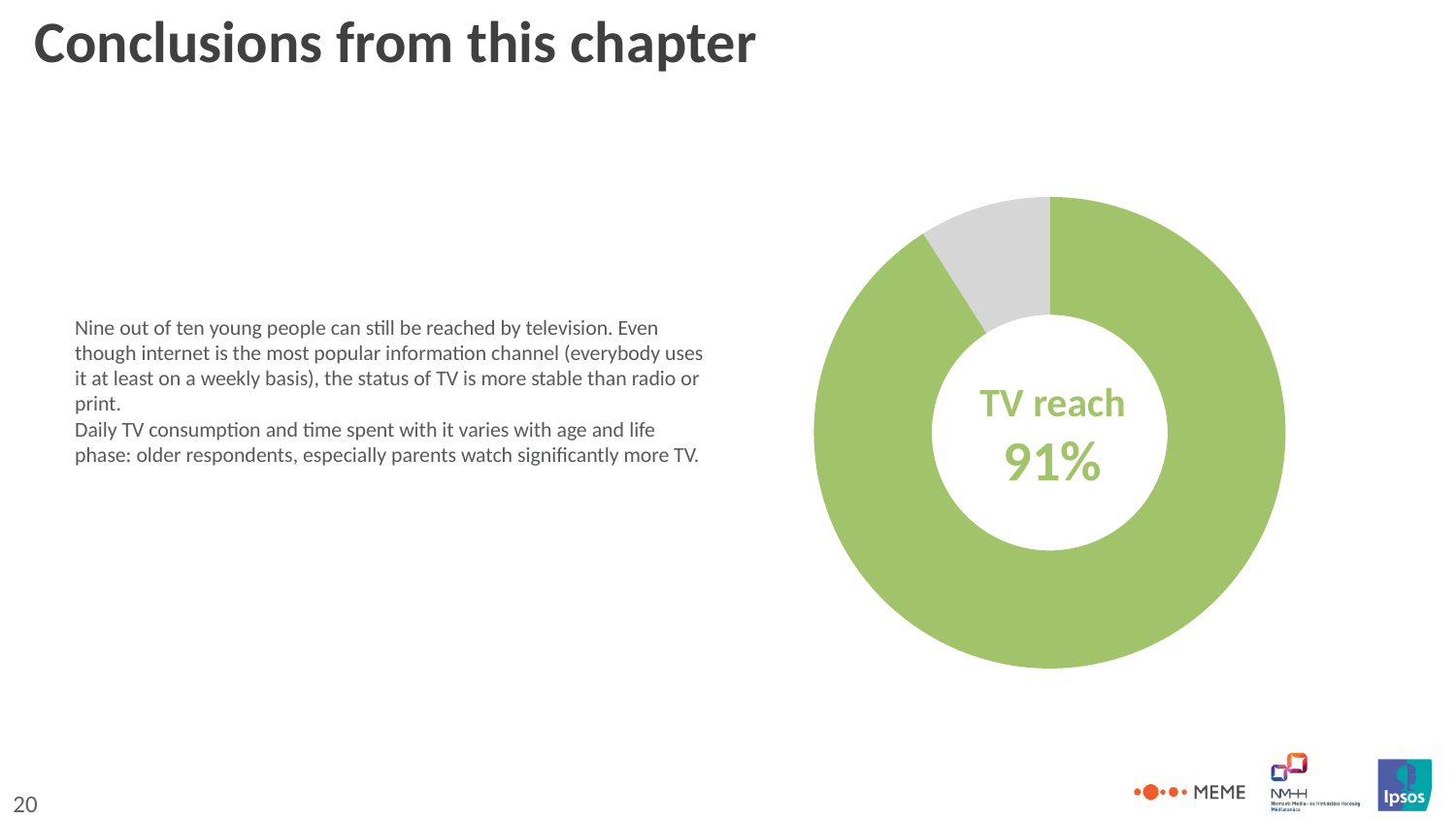
Which slice of the donut chart is the smallest? The grey slice What kind of chart is shown on the slide? Donut chart What colour is the slice representing TV reach in the donut chart? Green What label is printed in the centre of the donut chart? TV reach 91% What value is shown for TV reach in the donut chart? 91% What share of the donut chart does the green slice represent? 91% Which slice of the donut chart is larger, the green one or the grey one? The green one How many slices does the donut chart have? 2